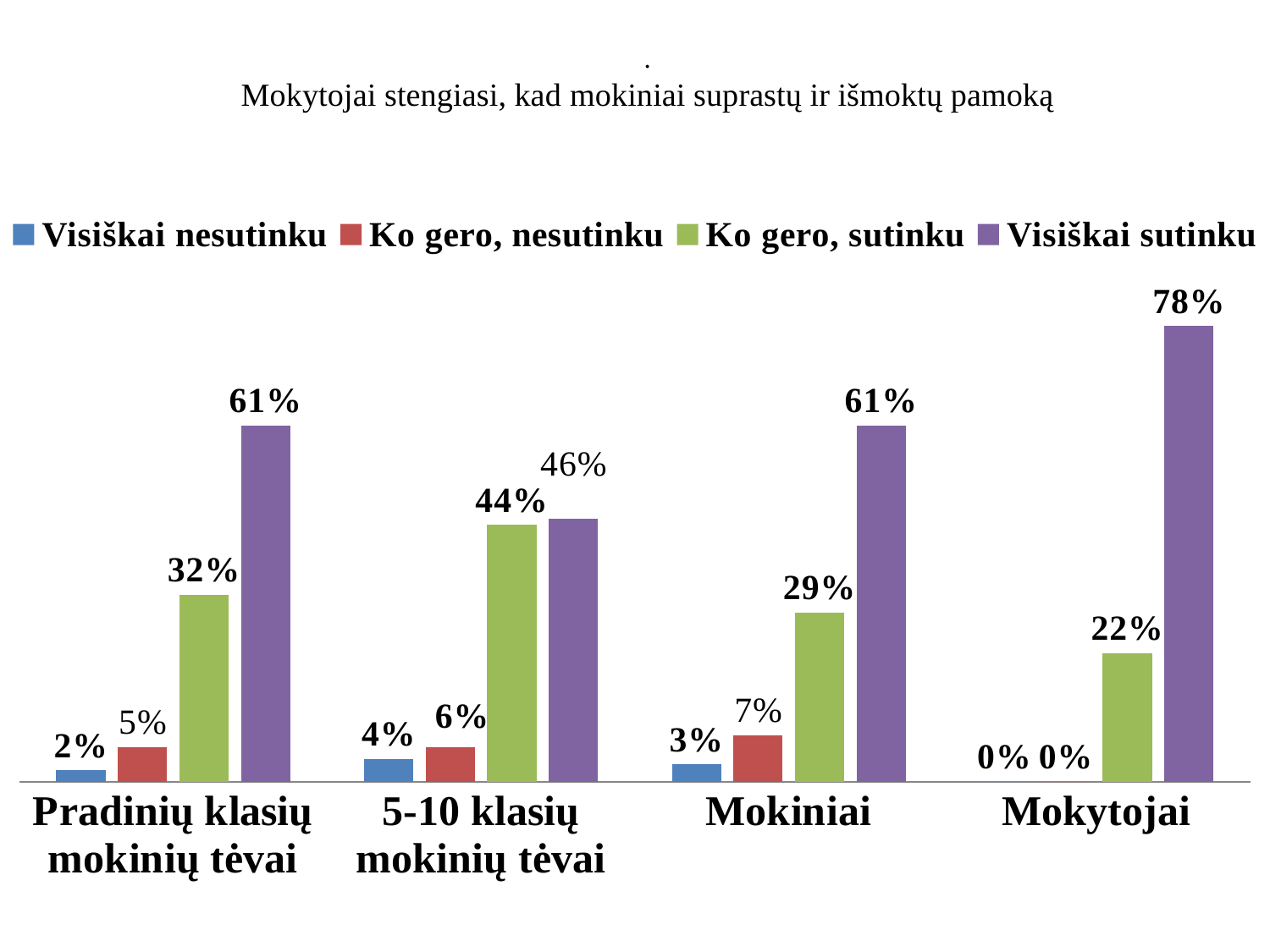
What is the value for "Visiškai sutinku" for Mokytojai? 78% What is the value for "Visiškai nesutinku" for Pradinių klasių mokinių tėvai? 2% What kind of chart is shown on the slide? Bar chart What is the difference between the "Visiškai sutinku" values for Mokytojai and Mokiniai? 17% Which is larger: "Ko gero, sutinku" for Pradinių klasių mokinių tėvai or for Mokiniai? Pradinių klasių mokinių tėvai How many categories are shown on the x axis? 4 Which legend entry is shown in purple? Visiškai sutinku Which category has the lowest value for "Ko gero, sutinku"? Mokytojai What is the value for "Ko gero, nesutinku" for Mokiniai? 7% How many series does the legend list? 4 Which category has the highest value for "Visiškai sutinku"? Mokytojai What is the value for "Ko gero, sutinku" for 5-10 klasių mokinių tėvai? 44%